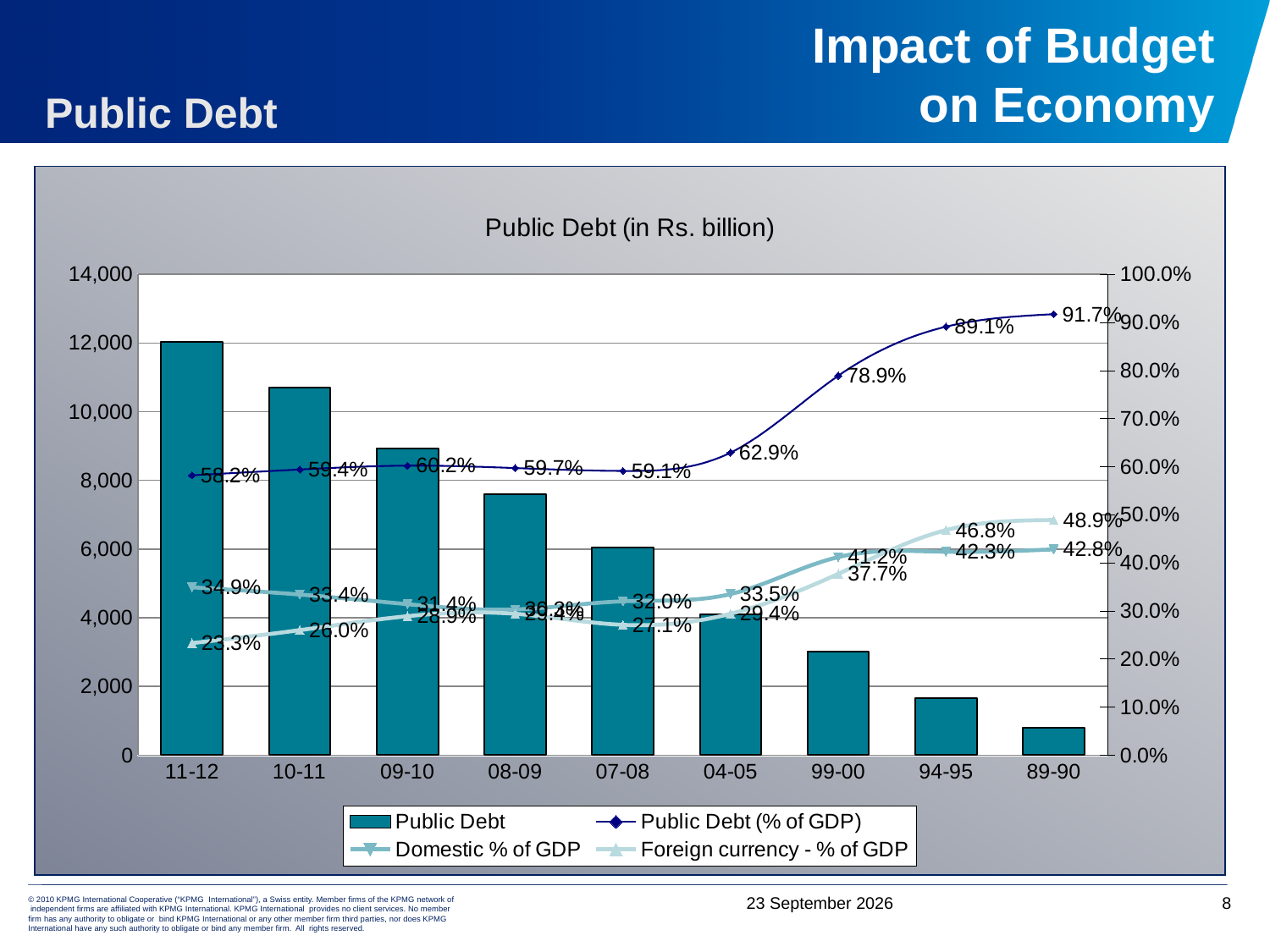
What is the Public Debt (% of GDP) value for 04-05? 62.9% How many series does the legend of the Public Debt chart list? 4 What kind of chart is shown on the slide? A combined bar and line chart Is the Public Debt bar for 11-12 greater or less than 10,000? greater Which fiscal year has the lowest Public Debt bar? 89-90 Which fiscal year has the highest Public Debt bar? 11-12 For 99-00, which is larger: Domestic % of GDP or Foreign currency - % of GDP? Domestic % of GDP How many fiscal-year categories are shown on the x axis of the Public Debt chart? 9 What is the Foreign currency - % of GDP value for 94-95? 46.8% What is the Domestic % of GDP value for 11-12? 34.9% What is the Public Debt (% of GDP) value for 89-90? 91.7% What is the difference between the Public Debt (% of GDP) values for 89-90 and 11-12? 33.5 percentage points